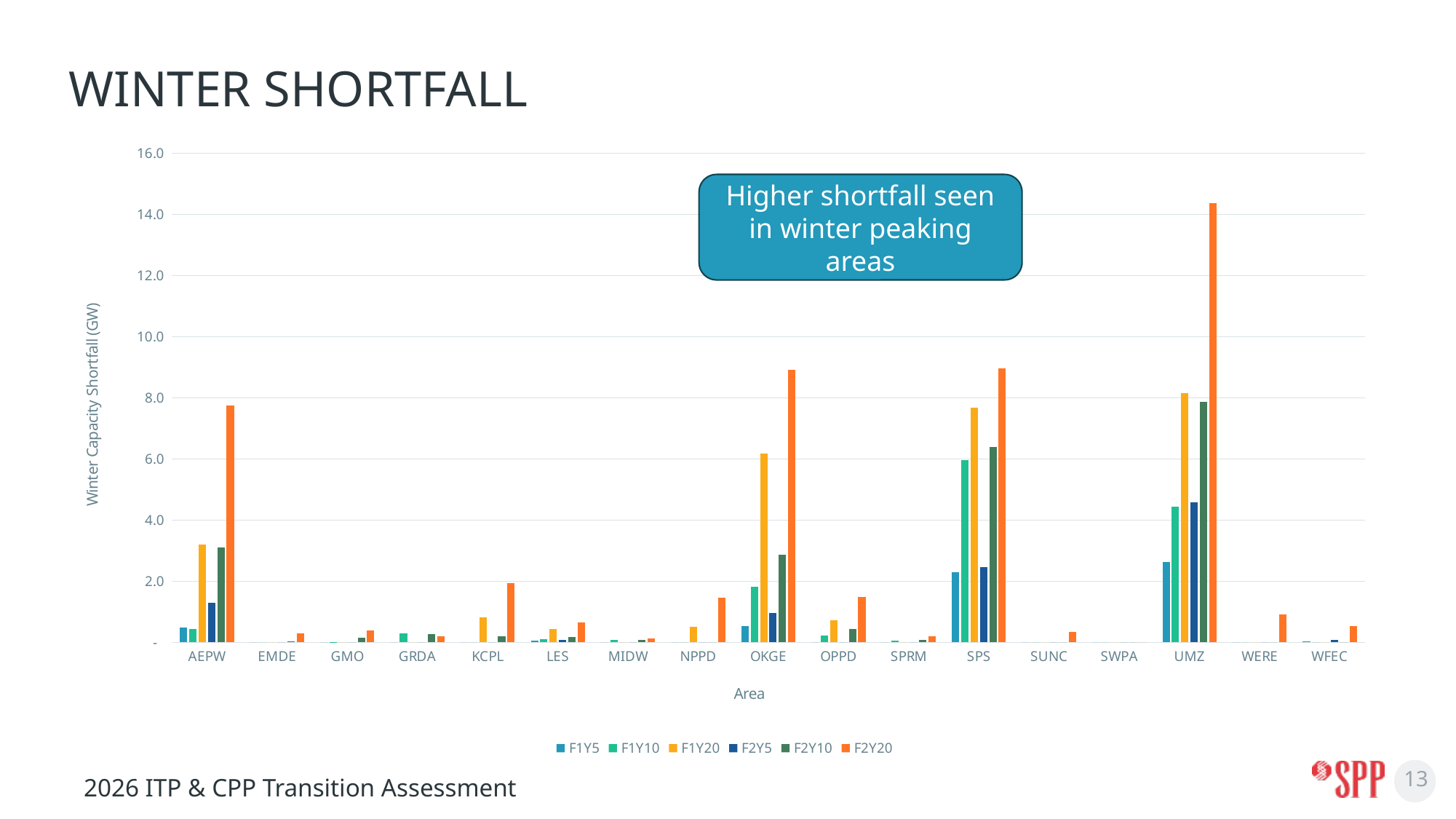
How many areas are shown on the x axis of the chart? 17 What is the label of the x axis of the chart? Area How many series does the chart legend list? 6 Is the F2Y20 value for UMZ greater or less than 12.0? greater Is the F2Y20 value for OKGE greater or less than 8.0? greater Is the F1Y20 value for SPS greater or less than 8.0? less Which area has the highest F2Y20 winter capacity shortfall? UMZ Which is larger for OKGE, the F1Y20 value or the F2Y10 value? F1Y20 What is the label of the y axis of the chart? Winter Capacity Shortfall (GW) What type of chart is shown on the slide? bar chart Which is larger for UMZ, the F2Y20 value or the F1Y20 value? F2Y20